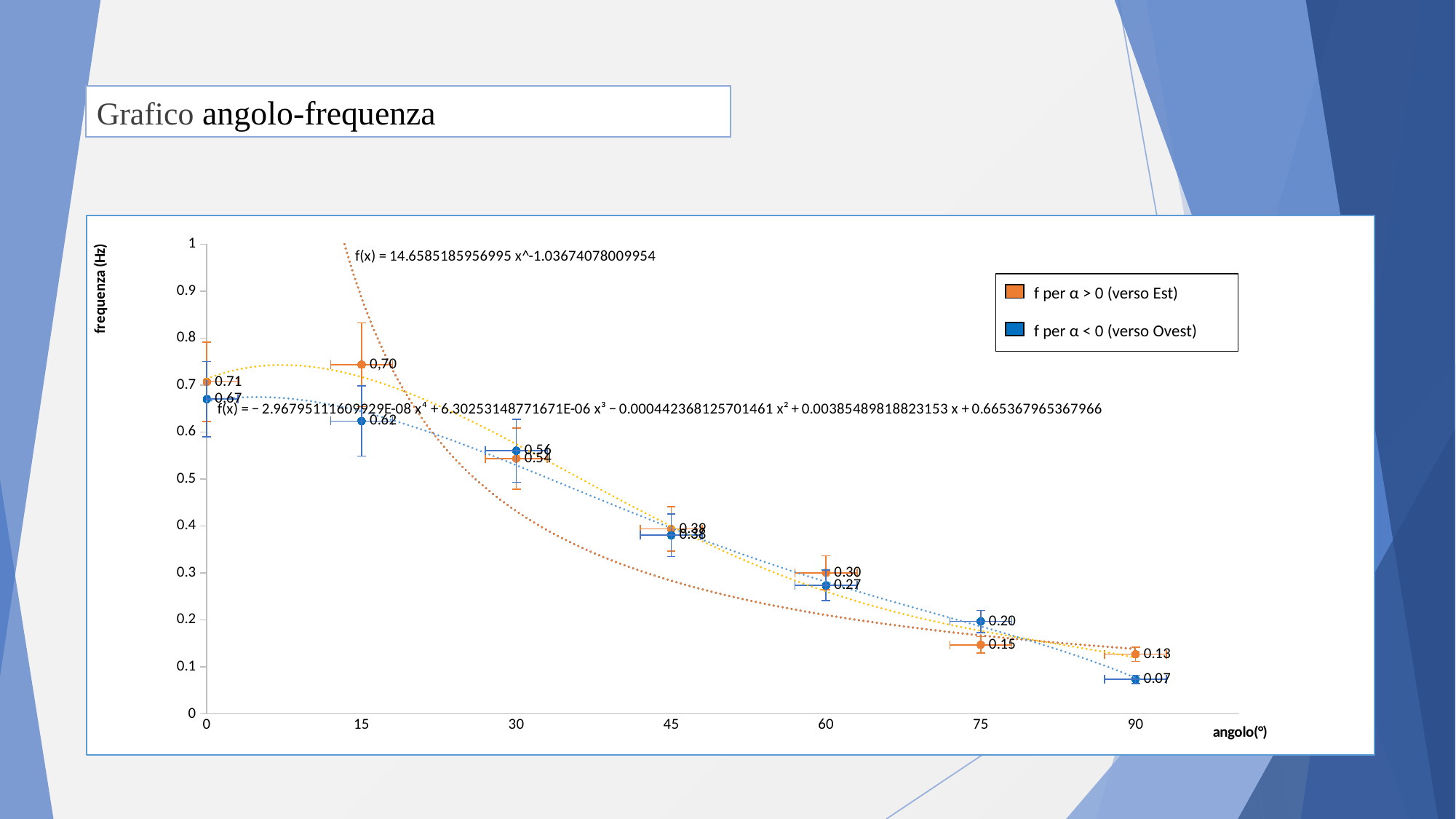
What kind of chart is shown on the slide? scatter chart How many data points are plotted for the series 'f per α > 0 (verso Est)'? 7 What is the frequency value for the series 'f per α < 0 (verso Ovest)' at an angle of 90°? 0.07 Do the frequency values for 'f per α < 0 (verso Ovest)' rise or fall as the angle increases from 0° to 90°? fall At an angle of 75°, which series has the larger frequency value, 'f per α > 0 (verso Est)' or 'f per α < 0 (verso Ovest)'? f per α < 0 (verso Ovest) Is the value for 'f per α > 0 (verso Est)' at 60° greater or less than 0.5? less What is the frequency value for the series 'f per α > 0 (verso Est)' at an angle of 30°? 0.54 What is the frequency value for the series 'f per α < 0 (verso Ovest)' at an angle of 75°? 0.20 At which angle does the series 'f per α < 0 (verso Ovest)' have its lowest frequency value? 90 What is the difference between the 'f per α > 0 (verso Est)' values at 0° and at 90°? 0.58 What is the frequency value for the series 'f per α > 0 (verso Est)' at an angle of 0°? 0.71 How many series does the legend list? 2